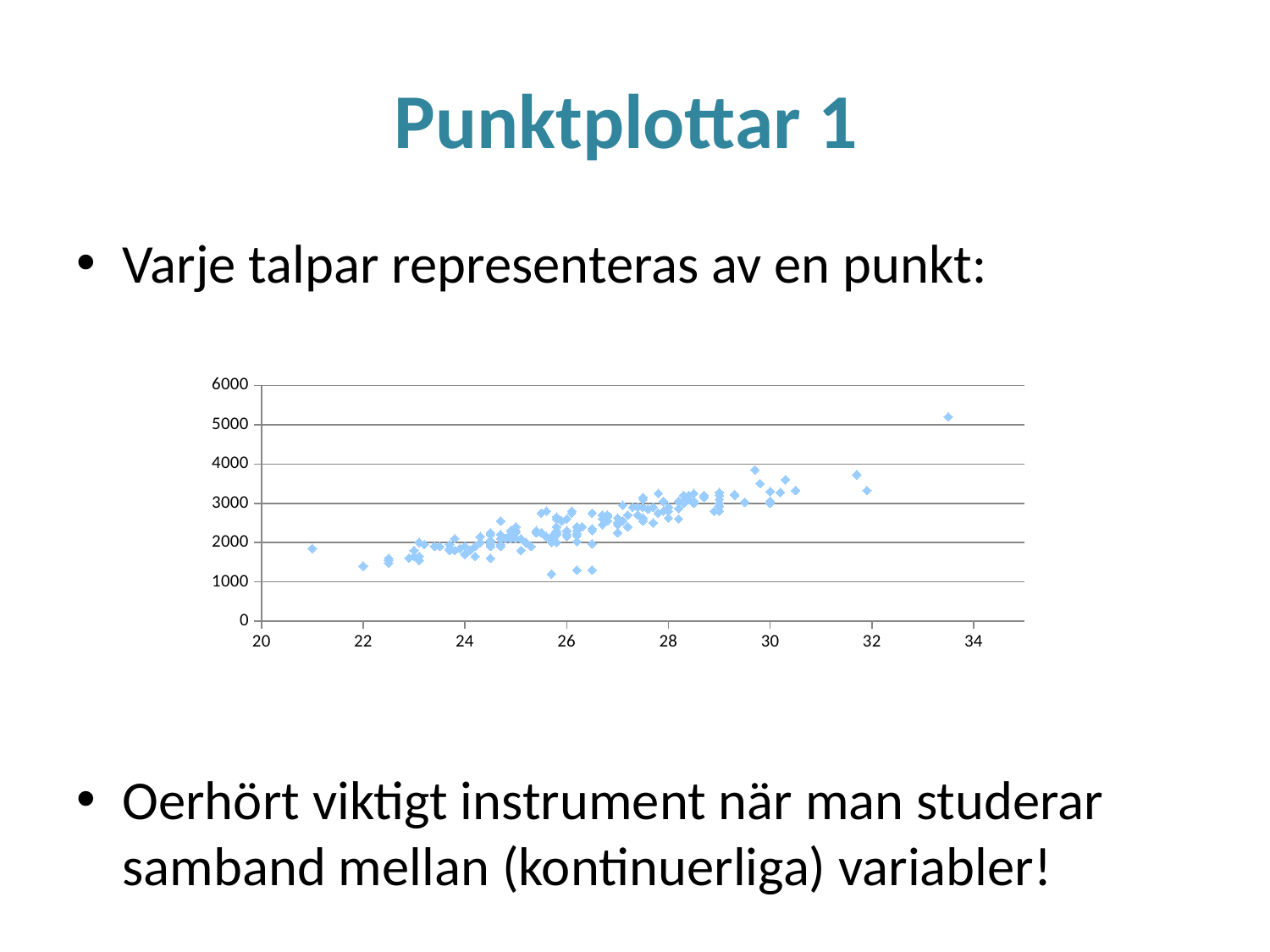
Is the point with the highest y value also the point with the largest x value? yes What is the maximum value shown on the y axis? 6000 Is the y value of the lowest point in the chart greater or less than 2000? less What kind of chart is shown on the slide? scatter plot How many points have a y value above 5000? 1 How many points have an x value greater than 32? 1 What is the range of the x axis? 20 to 34 Is the y value of the highest point in the chart greater or less than 5000? greater How many points have a y value above 4000? 1 Is the y value of the leftmost point (near x = 21) greater or less than 3000? less Do the y values generally rise or fall as the x value increases? rise